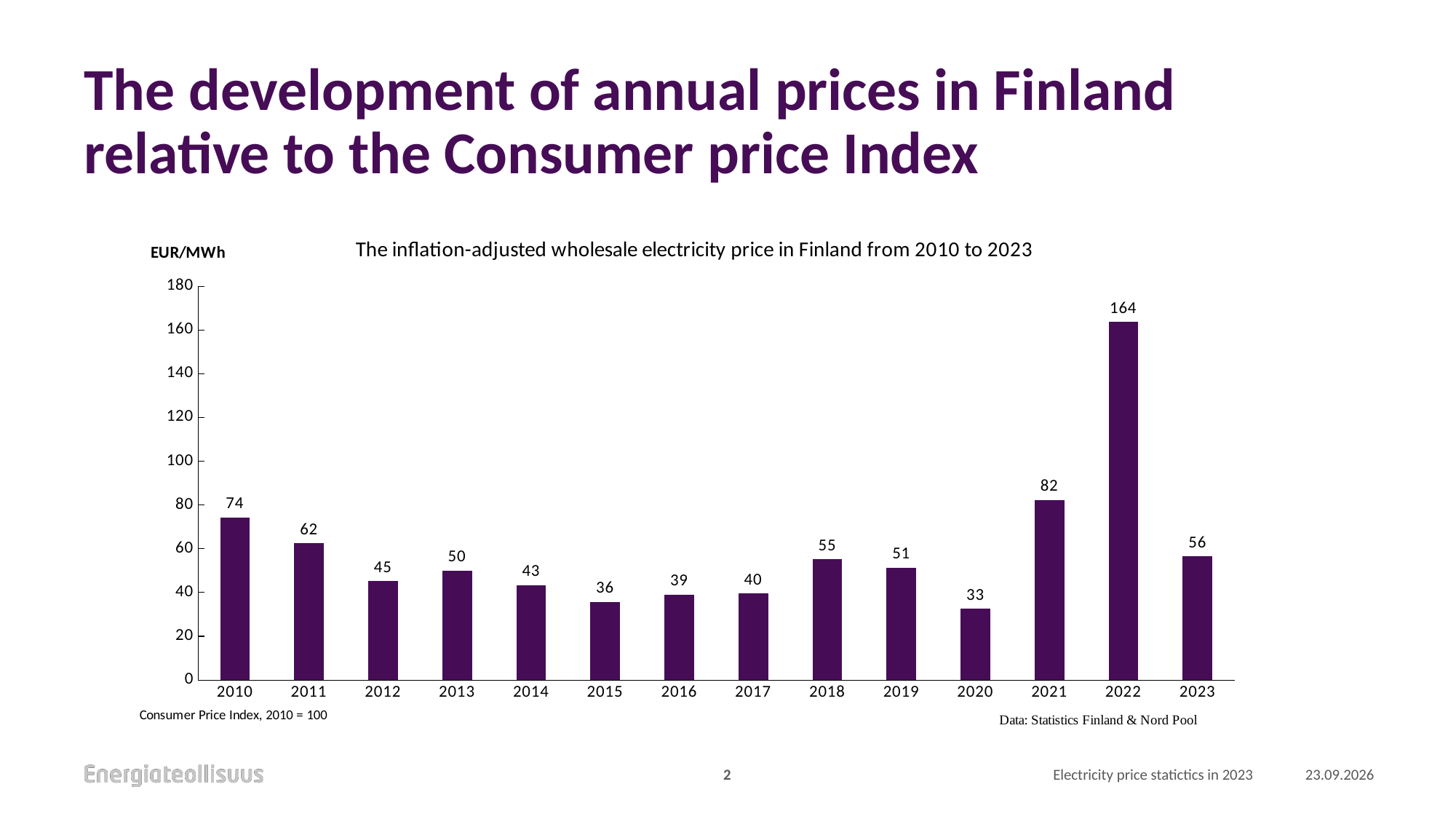
How many years are shown on the x axis? 14 What is the inflation-adjusted wholesale electricity price for 2022? 164 Which year has the lowest value? 2020 What is the value shown for 2020? 33 What is the difference between the values for 2022 and 2023? 108 Is the value for 2021 greater or less than 100? less Which is larger, the value for 2011 or the value for 2018? 2011 What is the difference between the values for 2021 and 2020? 49 Which year has the highest value? 2022 What unit is shown on the y axis of the chart? EUR/MWh What kind of chart is shown on the slide? bar chart What is the value shown for 2010? 74